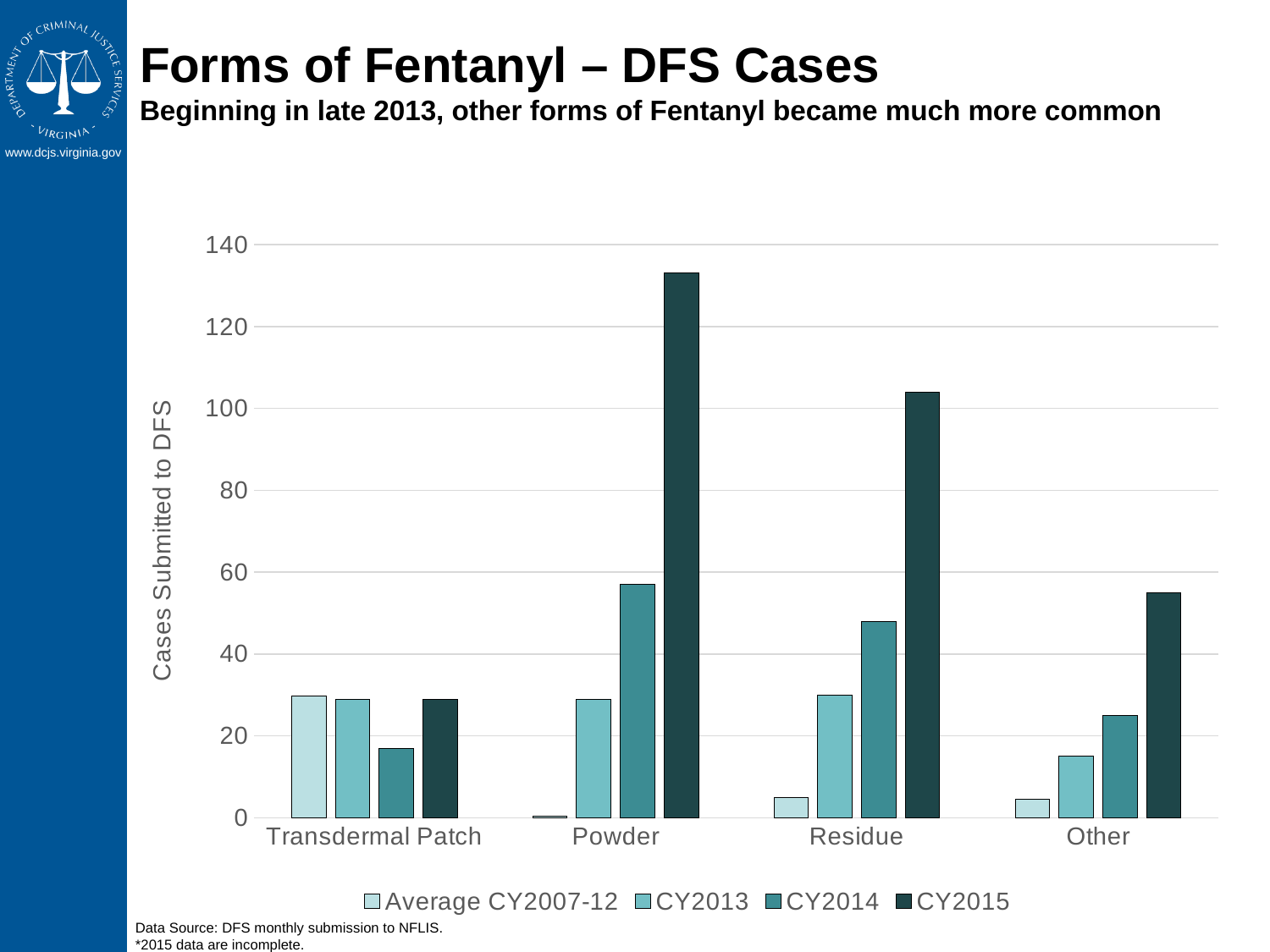
Is the CY2015 value for Other greater or less than 40? greater What is the title of the vertical axis? Cases Submitted to DFS How many series does the legend list? 4 What kind of chart is shown on the slide? bar chart Which category has the highest CY2015 bar? Powder Which category has the lowest Average CY2007-12 bar? Powder How many categories are shown on the x axis of the chart? 4 Which is larger, the CY2014 value for Powder or the CY2014 value for Residue? Powder Which is larger, the CY2015 value for Other or the CY2015 value for Transdermal Patch? Other Is the CY2014 value for Transdermal Patch greater or less than 20? less Is the CY2015 value for Powder greater or less than 120? greater